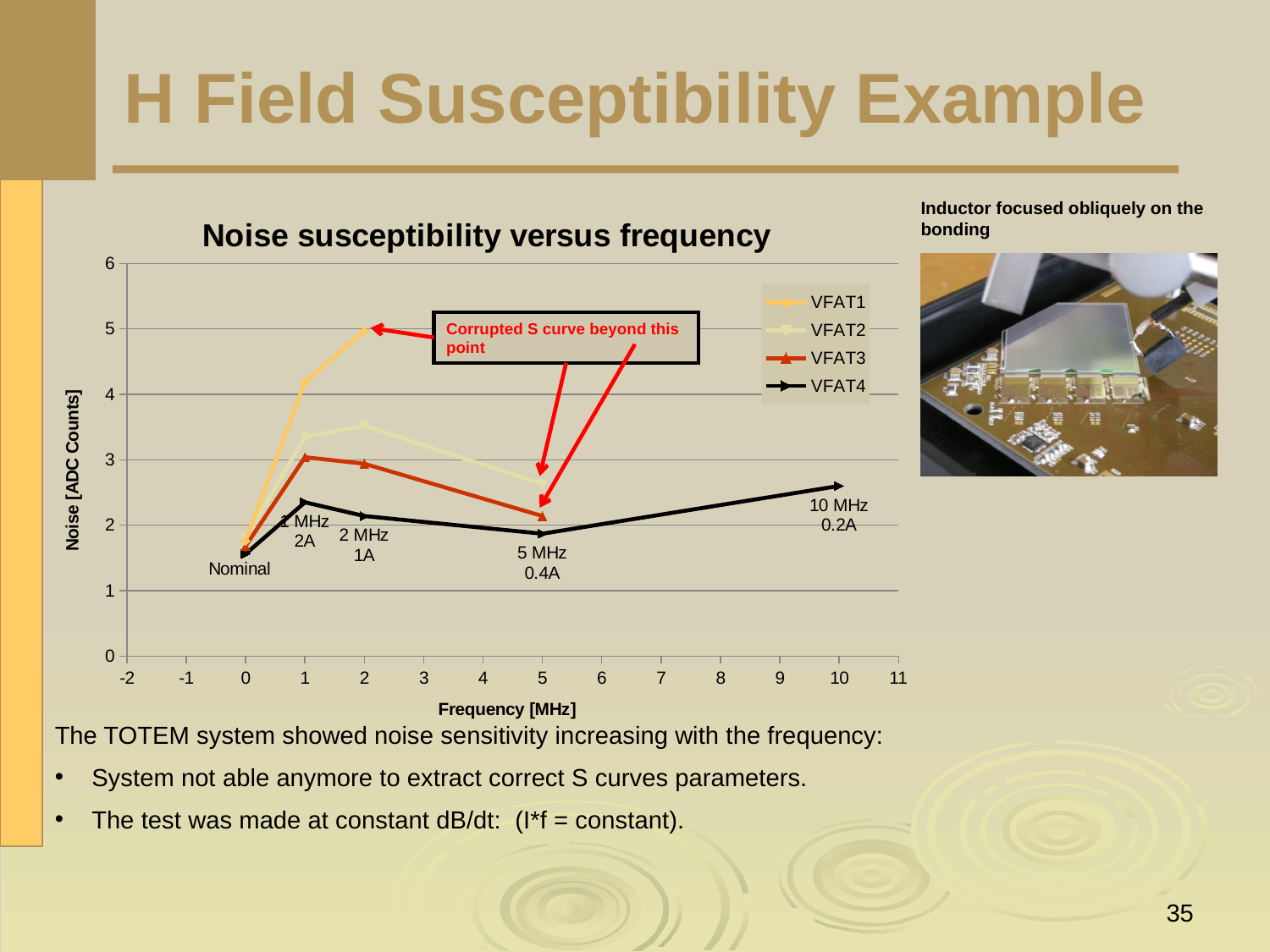
Is the VFAT4 value at 10 MHz greater or less than 2? greater What type of chart is 'Noise susceptibility versus frequency'? line chart How many series does the legend of the 'Noise susceptibility versus frequency' chart list? 4 Is the VFAT1 value at 2 MHz greater or less than 4? greater Which series reaches the highest noise value on the chart? VFAT1 Is the VFAT2 value at 2 MHz greater or less than 3? greater At 2 MHz, which series has the higher value, VFAT1 or VFAT4? VFAT1 Which series has the lowest value at 2 MHz? VFAT4 What is the x-axis label of the 'Noise susceptibility versus frequency' chart? Frequency [MHz] How many data points are plotted for the VFAT4 series? 5 What is the y-axis label of the 'Noise susceptibility versus frequency' chart? Noise [ADC Counts]